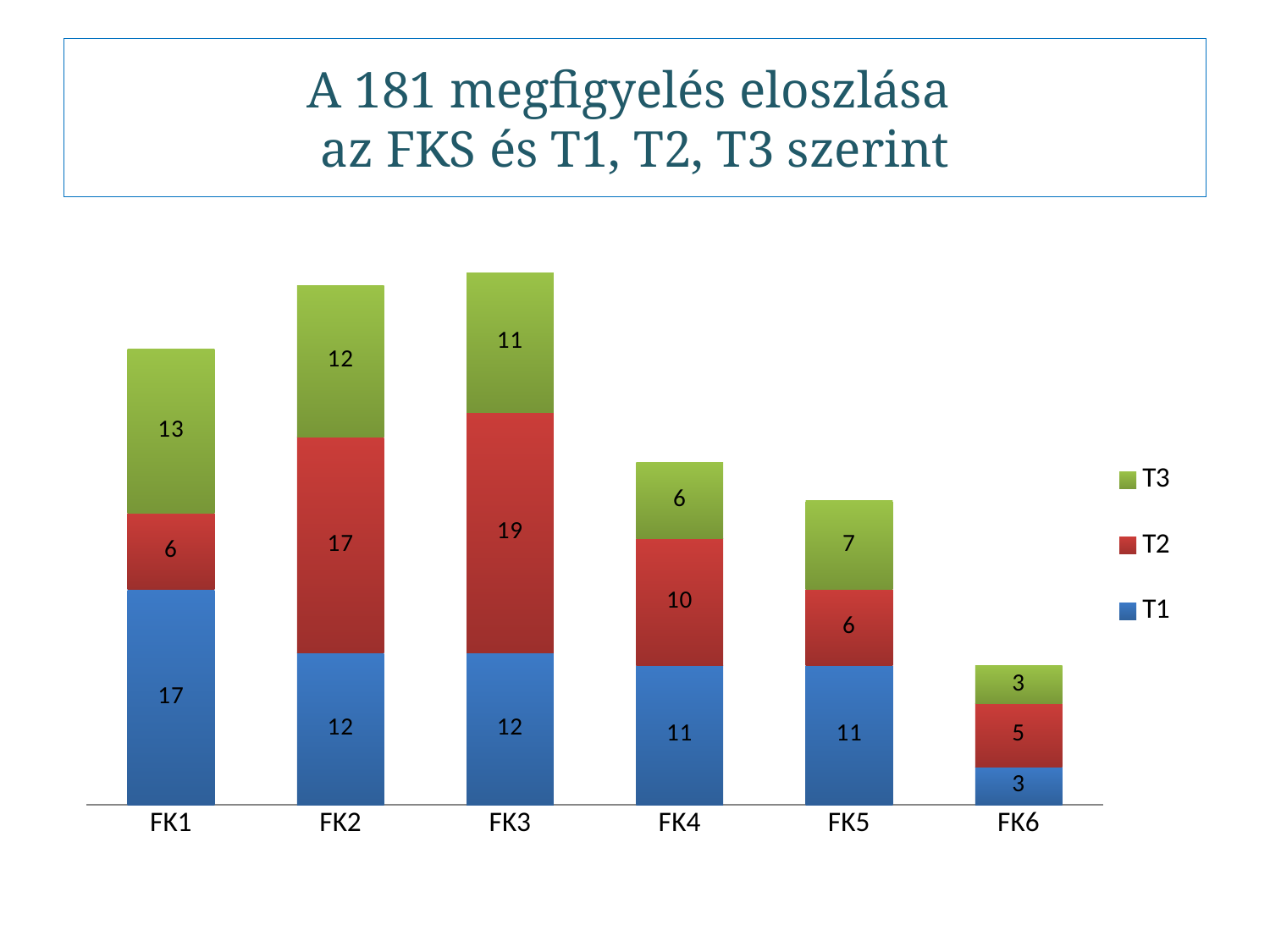
How many series does the legend list? 3 Which category has the lowest total across T1, T2 and T3? FK6 What is the difference between the T1 values of FK1 and FK6? 14 What type of chart is shown on the slide? stacked bar chart What is the T2 value for FK3? 19 Which series is shown in green in the legend? T3 Which is larger, the T3 value for FK1 or the T3 value for FK4? FK1 What is the total of the stacked bar for FK2? 41 How many categories are shown on the x axis? 6 What is the T3 value for FK5? 7 Which category has the highest T2 value? FK3 What is the T1 value for FK1? 17